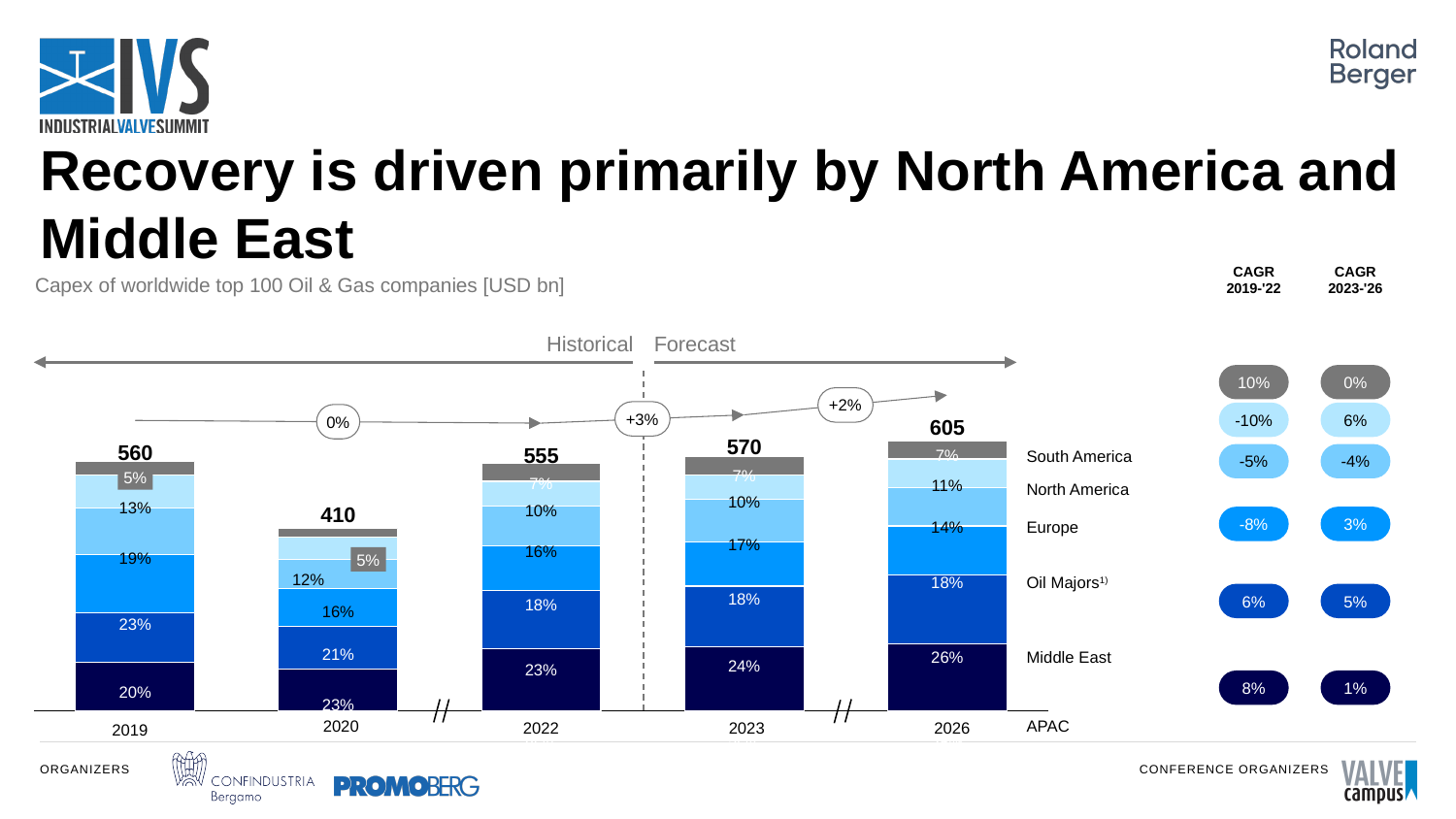
Which year has the lowest total capex? 2020 What share of capex does Middle East account for in 2019? 23% Which year has the highest total capex? 2026 What share of capex does Europe account for in 2020? 12% Is the total capex for 2019 larger or smaller than for 2022? larger What share of capex does APAC account for in 2026? 26% What is the total capex shown for 2026? 605 What is the total capex shown for 2020? 410 What kind of chart is used on the slide? Stacked bar chart What growth rate is annotated between 2022 and 2023? +3% How many years (bars) are shown in the chart? 5 What is the difference between the total capex in 2026 and in 2019? 45